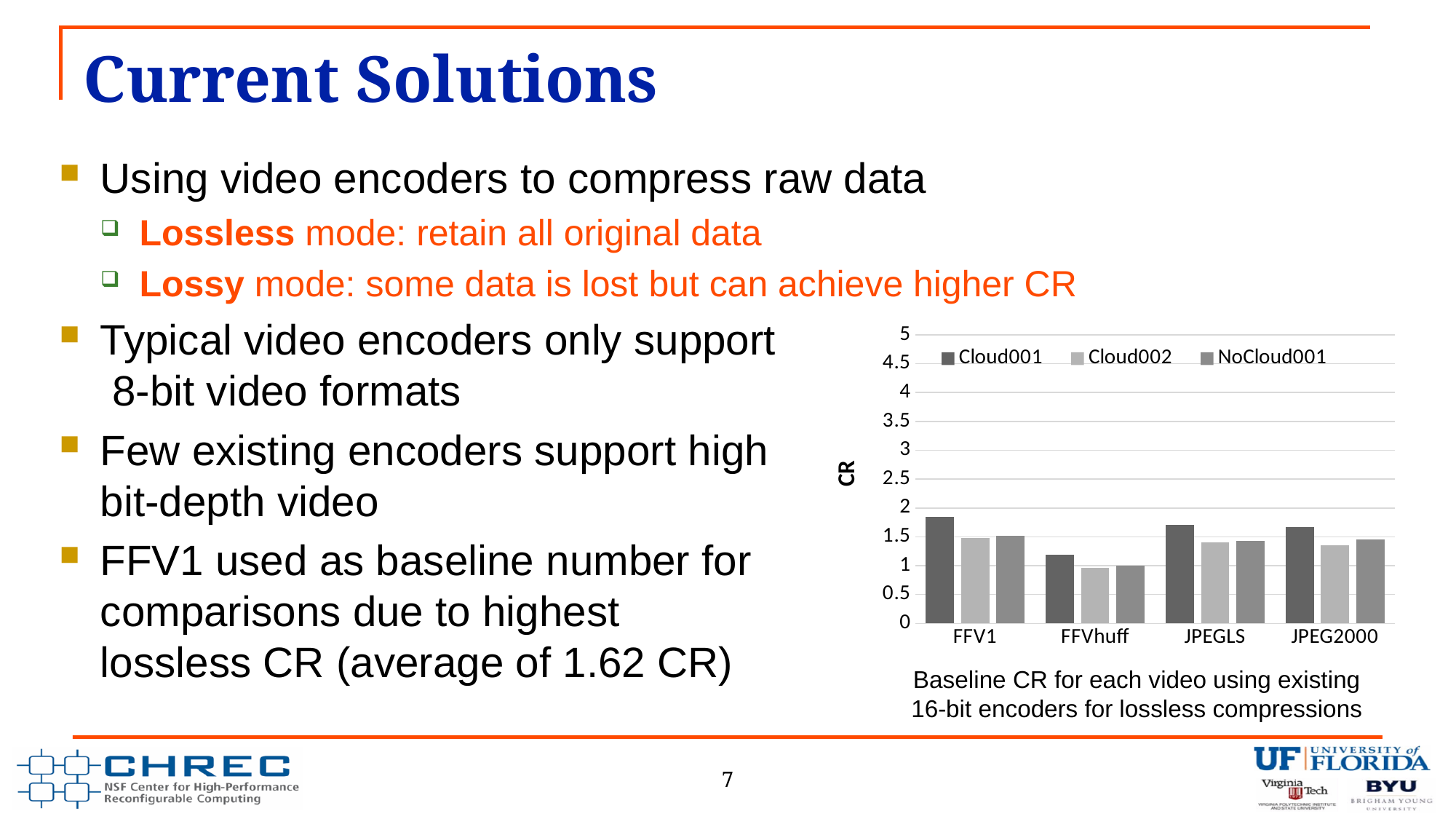
For which encoder is the Cloud001 bar the highest? FFV1 How many series does the chart's legend list? 3 What is the label on the vertical axis of the chart? CR How many encoder categories are shown on the x axis of the chart? 4 Which series are listed in the chart's legend? Cloud001, Cloud002, NoCloud001 Is the Cloud001 value for FFVhuff greater or less than 1.5? less For which encoder is the Cloud001 bar the lowest? FFVhuff Is the Cloud001 value for JPEGLS greater or less than 1.5? greater What kind of chart is shown on the slide? bar chart For FFV1, which is larger: the Cloud001 bar or the Cloud002 bar? Cloud001 Is the Cloud002 value for JPEGLS greater or less than 1.5? less